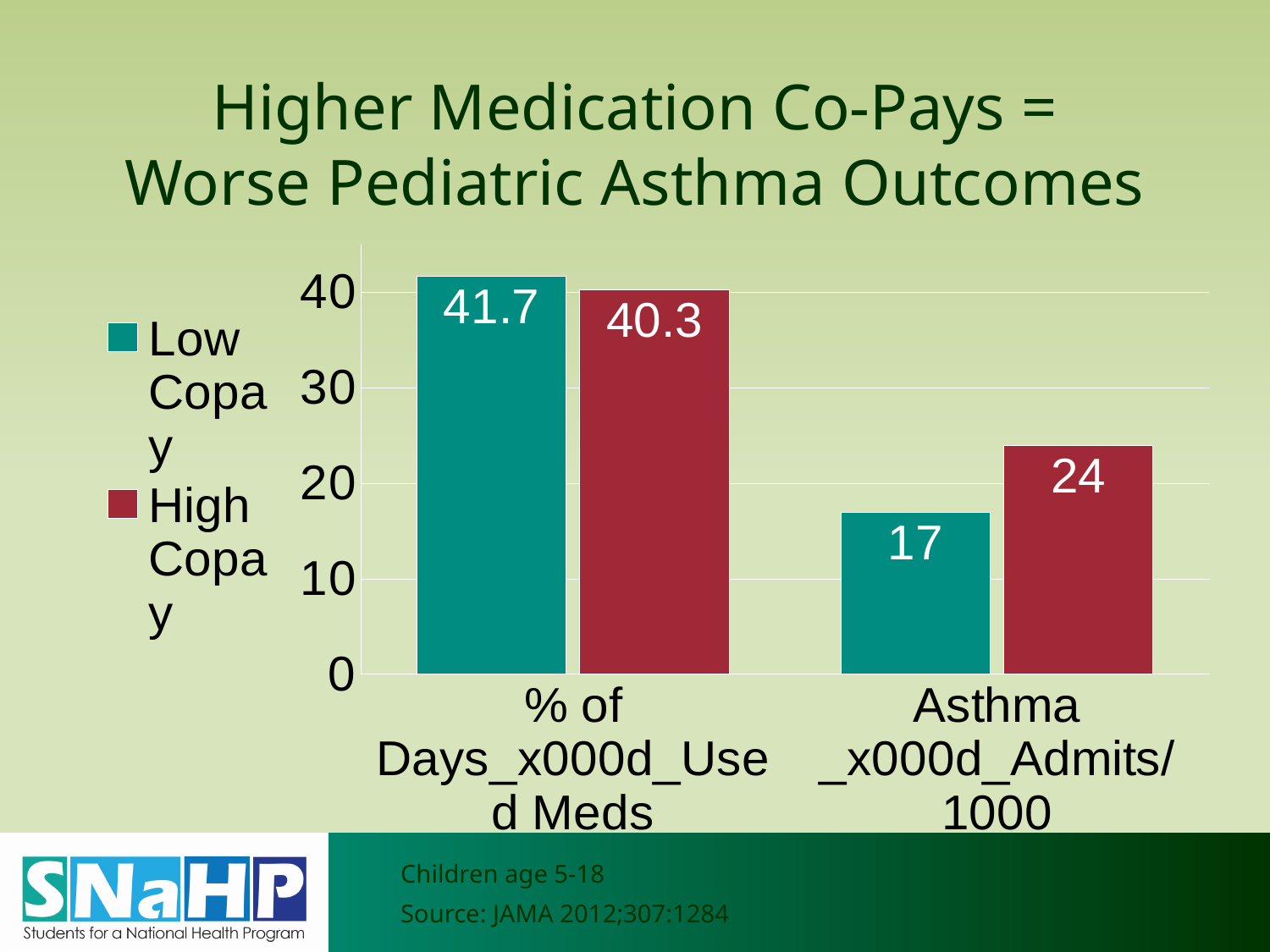
Which bar has the lowest value on the chart? Low Copay, Asthma Admits/1000 What is the value for Low Copay in the '% of Days Used Meds' category? 41.7 What colour represents the High Copay series in the legend? Red How many categories are shown on the x axis? 2 What is the value for Low Copay in the 'Asthma Admits/1000' category? 17 What is the value for High Copay in the '% of Days Used Meds' category? 40.3 What is the value for High Copay in the 'Asthma Admits/1000' category? 24 What kind of chart is shown on the slide? Bar chart What is the difference between the Low Copay and High Copay values for '% of Days Used Meds'? 1.4 What is the difference between the High Copay and Low Copay values for 'Asthma Admits/1000'? 7 In the 'Asthma Admits/1000' category, which series has the larger value, Low Copay or High Copay? High Copay How many series does the legend list? 2